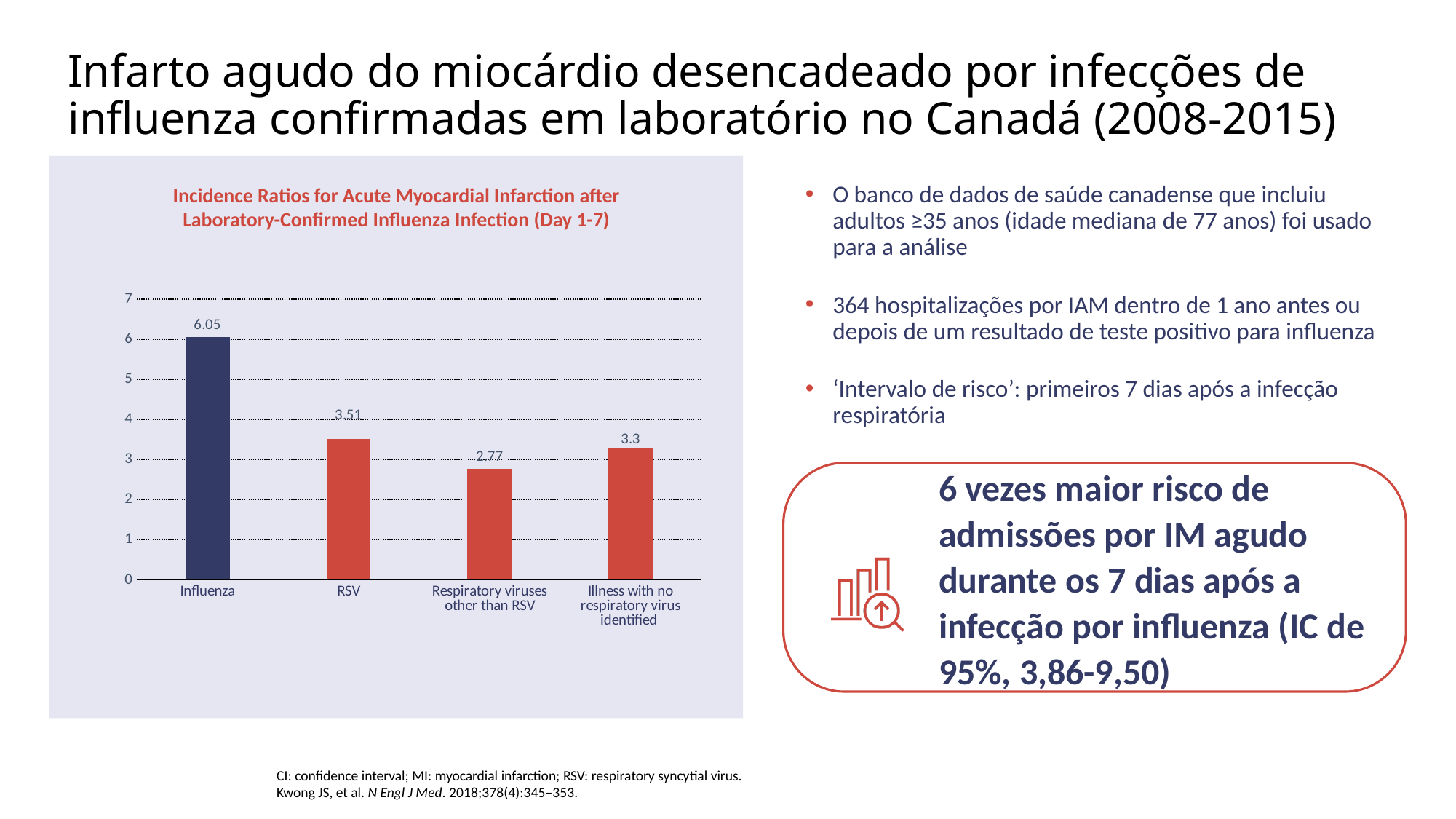
Which category has the highest incidence ratio? Influenza Is the value for Influenza greater or less than 5? greater What is the incidence ratio for Respiratory viruses other than RSV? 2.77 What is the incidence ratio for Illness with no respiratory virus identified? 3.3 Which category has the lowest incidence ratio? Respiratory viruses other than RSV What is the incidence ratio for Influenza? 6.05 What is the incidence ratio for RSV? 3.51 What is the difference between the incidence ratios for Influenza and RSV? 2.54 What is the title of the chart? Incidence Ratios for Acute Myocardial Infarction after Laboratory-Confirmed Influenza Infection (Day 1-7) Which is larger, the incidence ratio for RSV or for Illness with no respiratory virus identified? RSV How many categories are shown on the x axis? 4 What kind of chart is shown on the slide? Bar chart